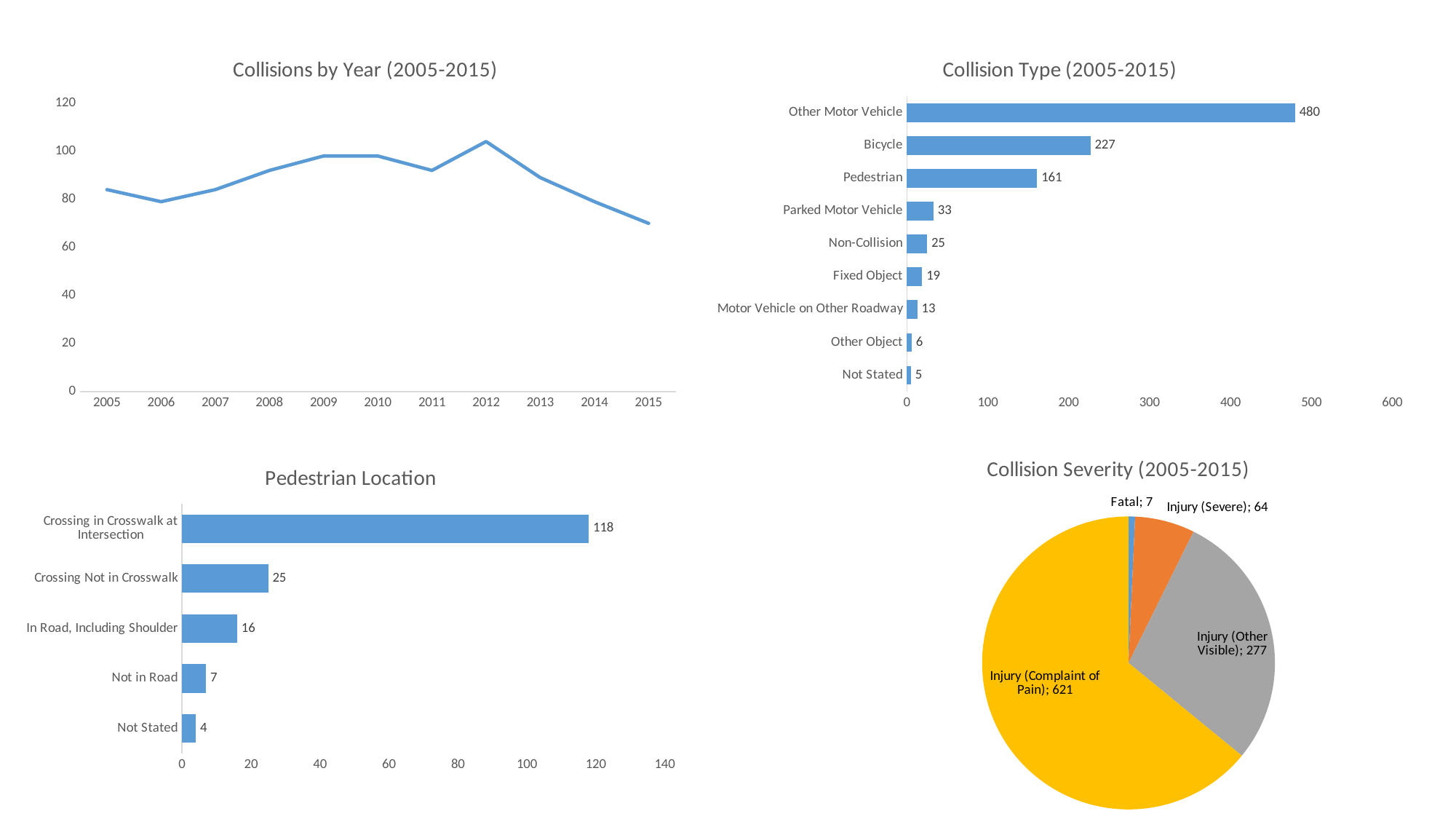
In the 'Pedestrian Location' chart, what is the value for Crossing Not in Crosswalk? 25 In the 'Collision Severity (2005-2015)' chart, what is the value for Injury (Other Visible)? 277 In the 'Collisions by Year (2005-2015)' chart, how many years are plotted on the x axis? 11 In the 'Collisions by Year (2005-2015)' chart, is the value for 2012 greater or less than 100? greater In the 'Collision Type (2005-2015)' chart, how many collision types are listed? 9 In the 'Pedestrian Location' chart, which location has the lowest value? Not Stated In the 'Collision Type (2005-2015)' chart, what is the value for Bicycle? 227 In the 'Collisions by Year (2005-2015)' chart, is the value for 2015 greater or less than 80? less In the 'Collision Type (2005-2015)' chart, what is the difference between Other Motor Vehicle and Bicycle? 253 In the 'Collision Severity (2005-2015)' chart, which is larger, Injury (Severe) or Fatal? Injury (Severe) In the 'Collision Type (2005-2015)' chart, which collision type has the highest value? Other Motor Vehicle In the 'Collisions by Year (2005-2015)' chart, what kind of chart is shown? line chart